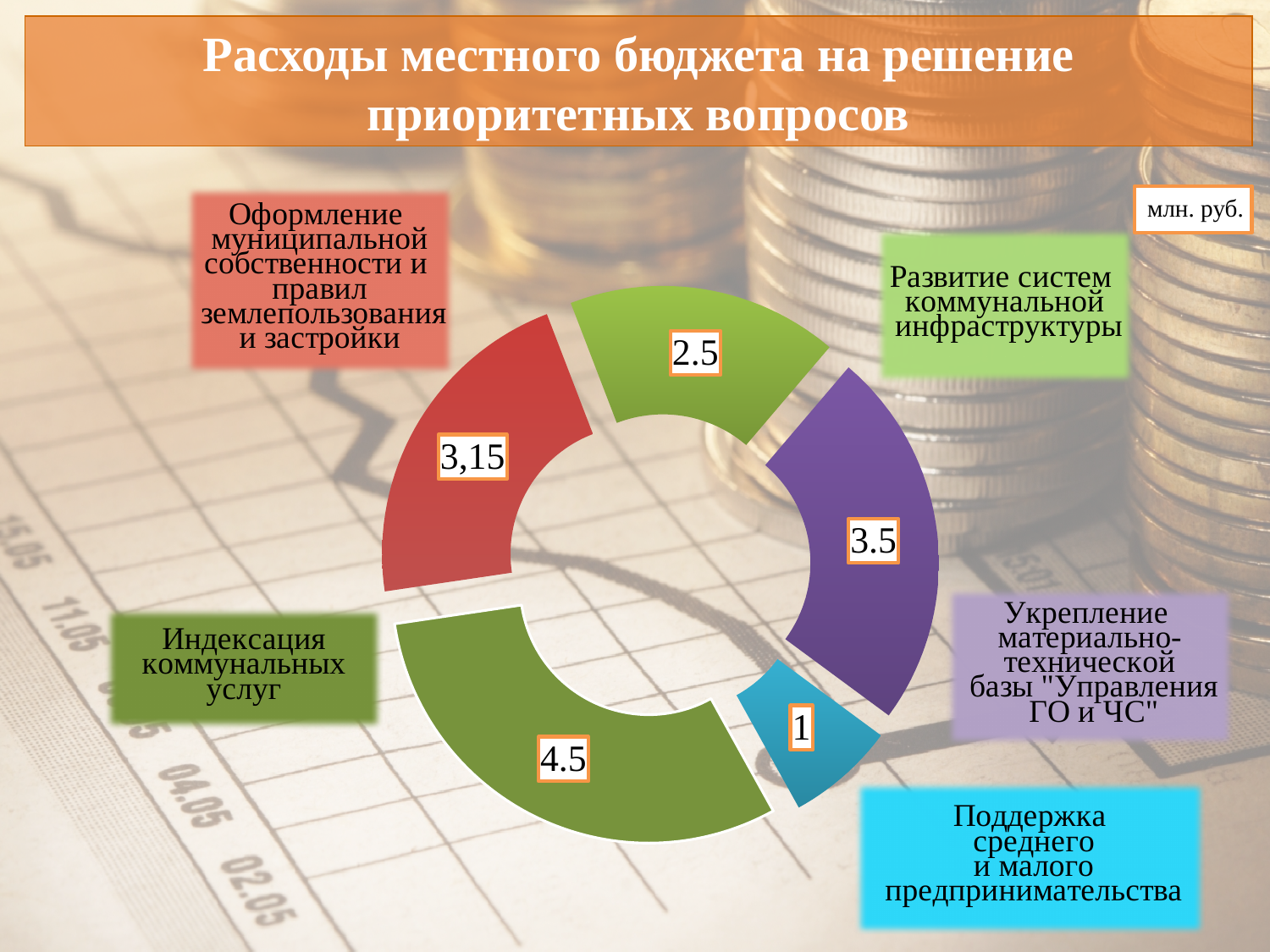
Which category has the smallest value? Поддержка среднего и малого предпринимательства What is the value for "Развитие систем коммунальной инфраструктуры"? 2.5 What type of chart is shown on the slide? doughnut chart What is the difference between the values for "Индексация коммунальных услуг" and "Укрепление материально-технической базы "Управления ГО и ЧС""? 1 Which is larger: the value for "Укрепление материально-технической базы "Управления ГО и ЧС"" or for "Развитие систем коммунальной инфраструктуры"? Укрепление материально-технической базы "Управления ГО и ЧС" What unit of measurement is indicated for the chart values? млн. руб. What is the value for "Индексация коммунальных услуг"? 4.5 What is the value for "Поддержка среднего и малого предпринимательства"? 1 What is the value for "Оформление муниципальной собственности и правил землепользования и застройки"? 3,15 Which category has the largest value? Индексация коммунальных услуг What colour is the segment for "Поддержка среднего и малого предпринимательства"? blue How many segments does the doughnut chart have? 5